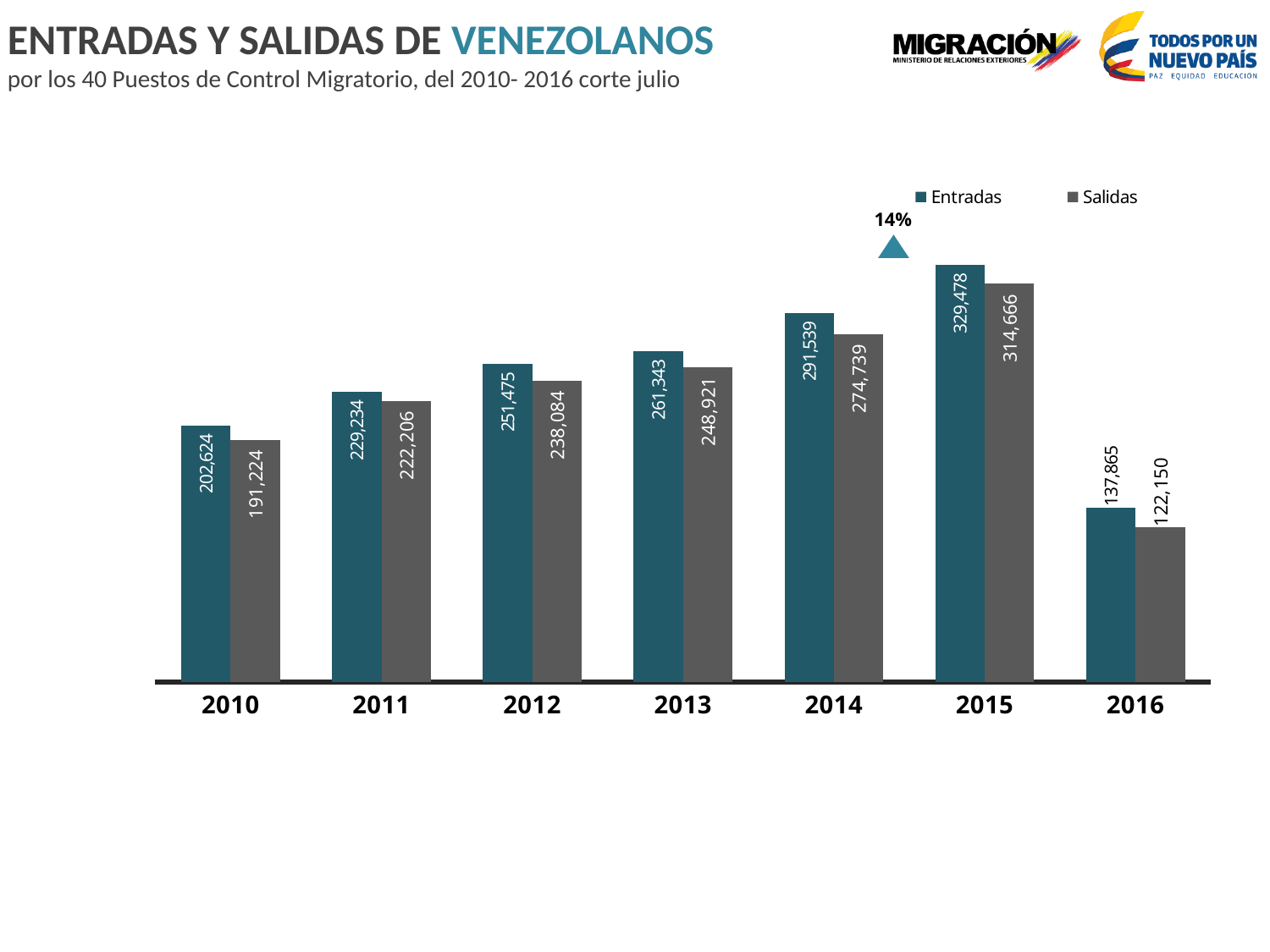
How many series does the legend list? 2 What percentage is shown above the 2015 bars next to the triangle? 14% What kind of chart is shown on the slide? Bar chart Which is larger in 2012, Entradas or Salidas? Entradas What is the difference between Entradas and Salidas in 2015? 14,812 What is the value of Entradas for 2016? 137,865 What is the value of Entradas for 2010? 202,624 Do the Entradas values rise or fall from 2010 to 2015? Rise How many years are shown on the x axis? 7 Which year has the highest value for Entradas? 2015 What is the value of Salidas for 2014? 274,739 Which year has the lowest value for Salidas? 2016